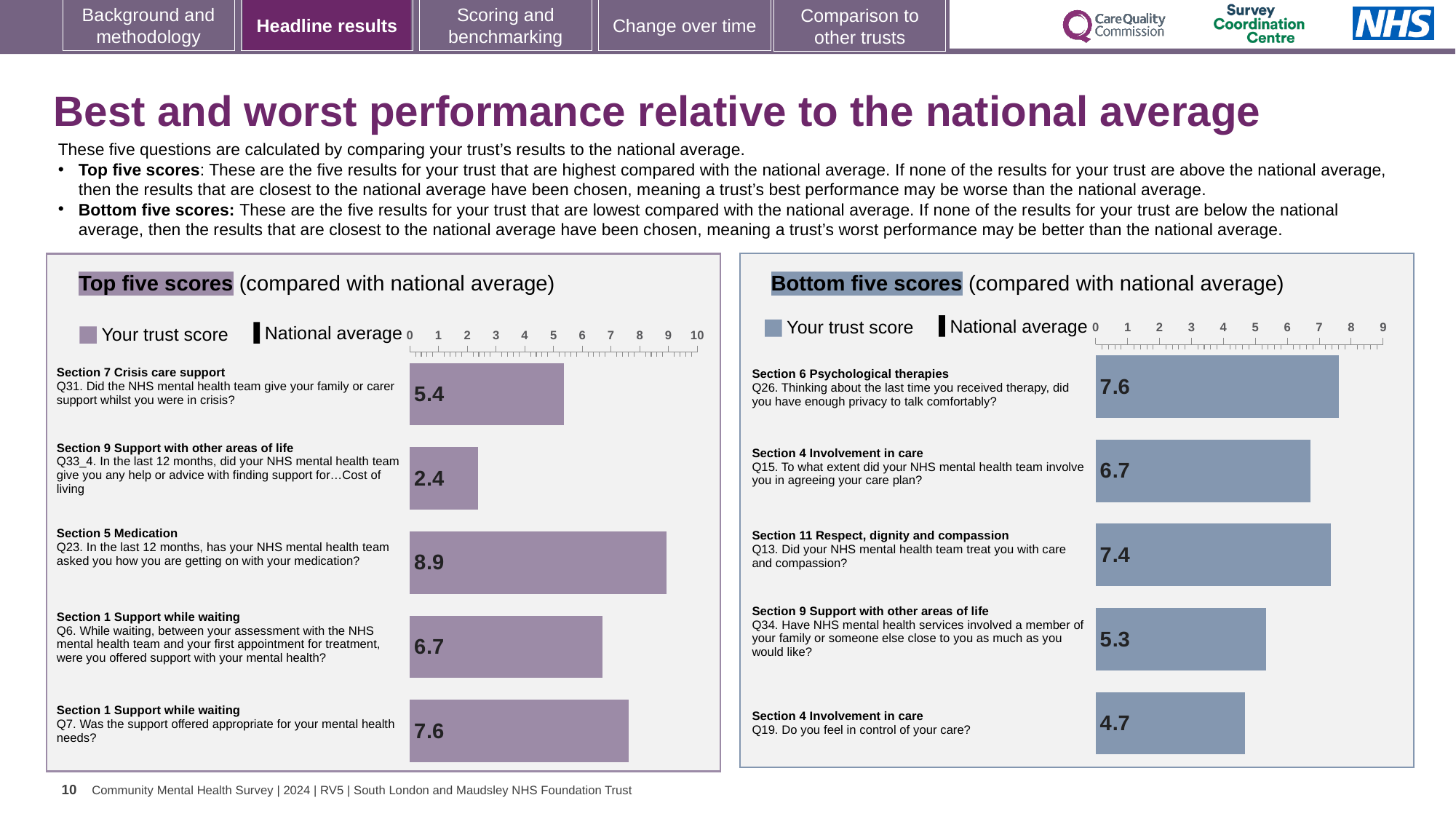
In the Bottom five scores chart, which question has the lowest trust score? Q19 In the Top five scores chart, what is the trust score for Q33_4 (help or advice with finding support for cost of living)? 2.4 In the Bottom five scores chart, what is the trust score for Q26 (enough privacy to talk comfortably)? 7.6 What kind of chart is the Bottom five scores chart? Bar chart In the Bottom five scores chart, what is the trust score for Q19 (do you feel in control of your care)? 4.7 In the Top five scores chart, what is the trust score for Q23 (asked how you are getting on with your medication)? 8.9 How many series does the legend of the Top five scores chart list? 2 In the Bottom five scores chart, which has the larger trust score, Q15 or Q13? Q13 In the Top five scores chart, what is the difference between the trust scores for Q7 and Q31? 2.2 How many questions are plotted in the Top five scores chart? 5 In the Bottom five scores chart, what is the difference between the trust scores for Q26 and Q34? 2.3 In the Top five scores chart, which question has the highest trust score? Q23